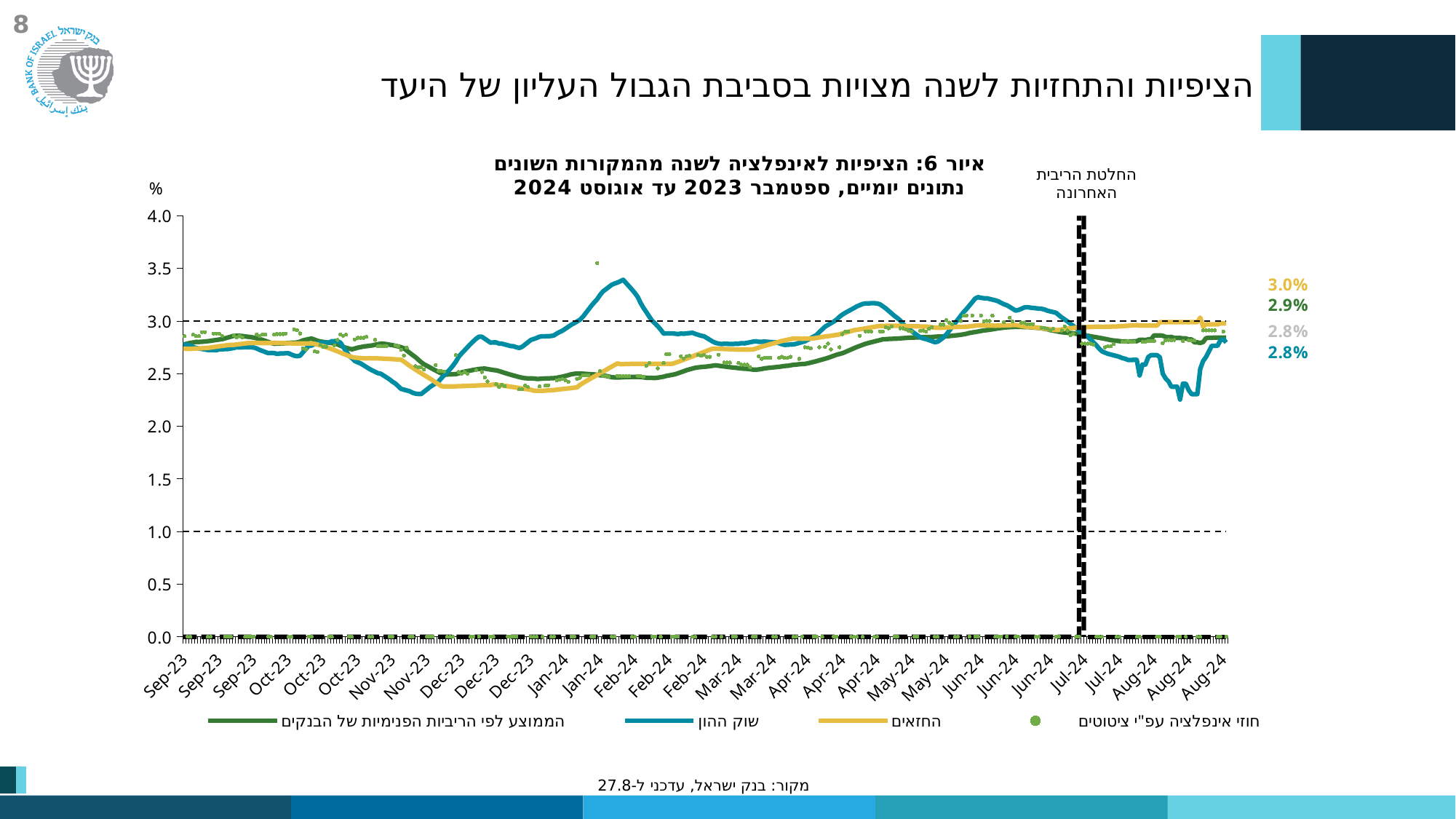
What is the latest value shown for the capital market (שוק ההון) series? 2.8% Does the capital market (שוק ההון) line rise or fall from Jan-24 to its peak in early Feb-24? rise At the end of the period, which is larger: the forecasters value or the banks' internal rates value? forecasters (3.0%) What is the latest value shown for the average by banks' internal interest rates (הממוצע לפי הריביות הפנימיות של הבנקים) series? 2.9% What is the difference between the end-of-period forecasters value (3.0%) and the banks' internal rates value (2.9%)? 0.1 percentage points Is the peak of the capital market (שוק ההון) line in Feb-24 greater or less than 3.0? greater What type of chart is shown on the slide? line chart What does the vertical dashed black line on the chart mark? החלטת הריבית האחרונה (the last interest rate decision) What is the latest value shown for the forecasters (החזאים) series? 3.0% How many series does the legend list? 4 Which series has the highest value at the end of the period, according to the end labels? החזאים (forecasters) Is the lowest point of the capital market (שוק ההון) line in Aug-24 greater or less than 2.5? less